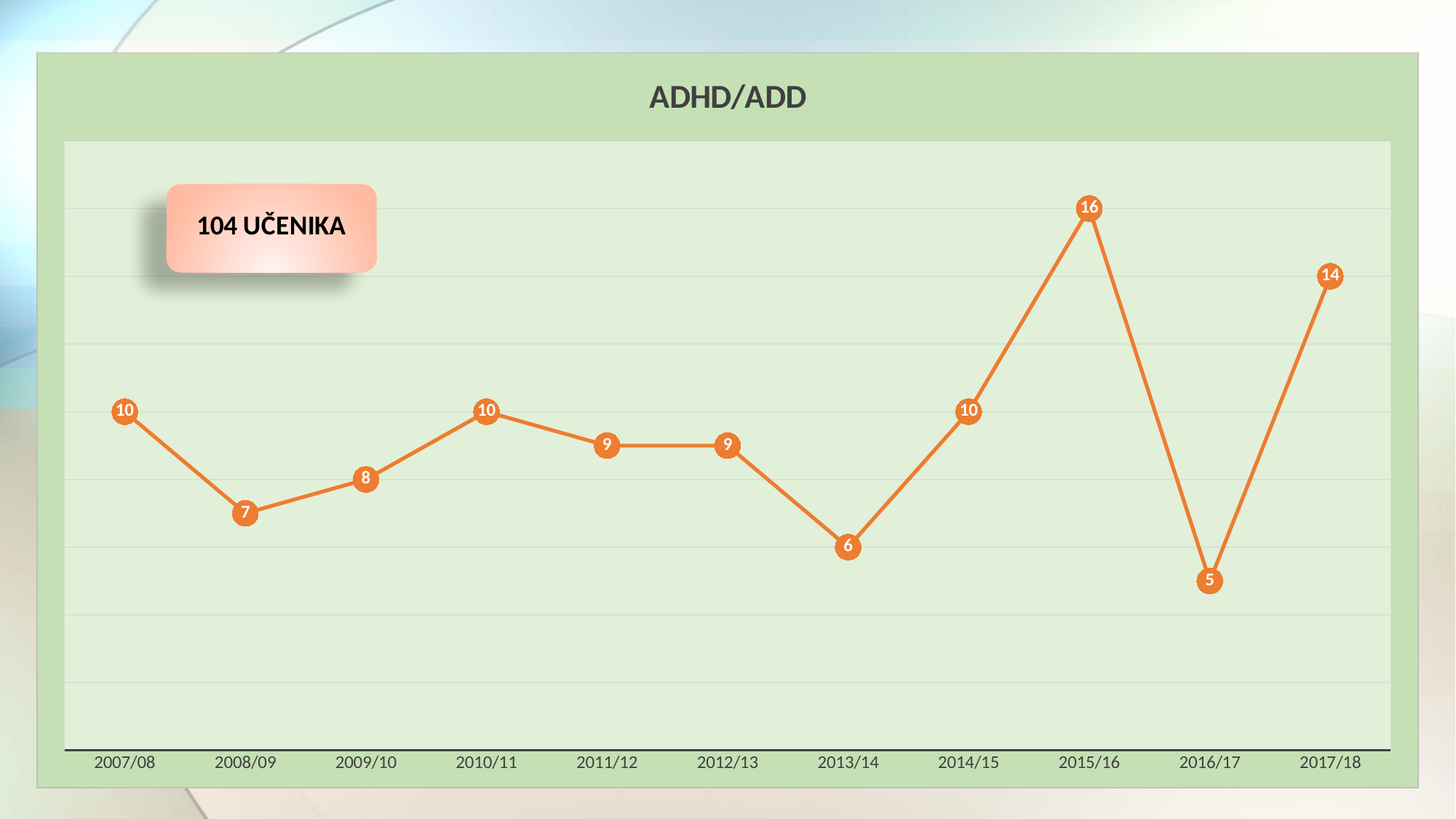
What is the difference between the values for 2015/16 and 2016/17? 11 Which school year has the highest value? 2015/16 What kind of chart is shown? line chart What is the value for 2013/14? 6 What is the value for 2017/18? 14 Which school year has the lowest value? 2016/17 What is the title of the chart? ADHD/ADD What is the difference between the values for 2017/18 and 2013/14? 8 How many school years are plotted on the chart? 11 Which is larger, the value for 2008/09 or the value for 2014/15? 2014/15 What is the value for 2016/17? 5 What is the value for 2015/16? 16